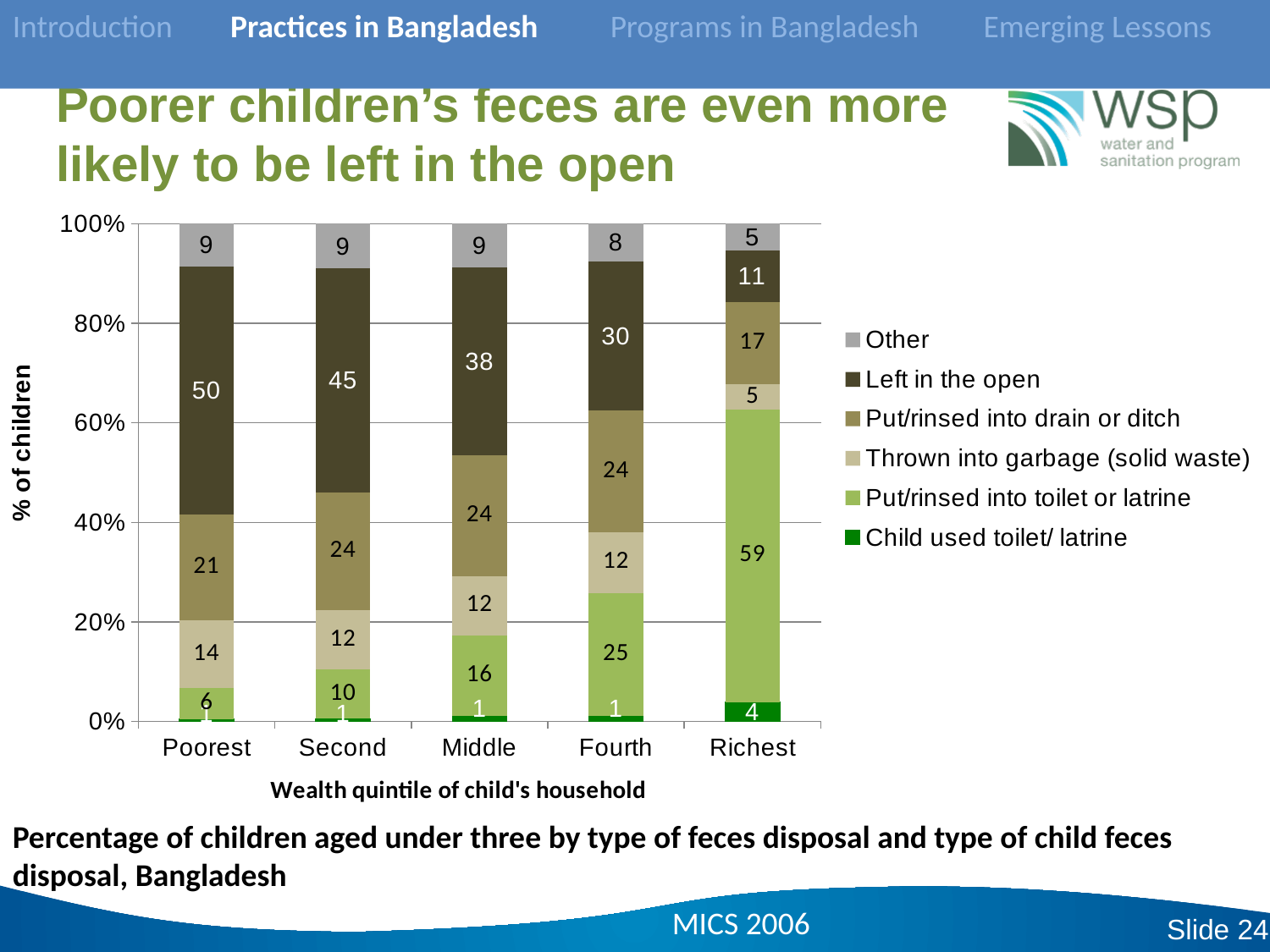
What is the value for "Left in the open" for the Poorest quintile? 50 How many series does the legend list? 6 Which wealth quintile has the lowest value for "Left in the open"? Richest Do the "Left in the open" values rise or fall from the Poorest to the Richest quintile? Fall Which has a larger value for "Put/rinsed into toilet or latrine": the Fourth quintile or the Middle quintile? Fourth What kind of chart is shown on the slide? Stacked bar chart What is the value for "Thrown into garbage (solid waste)" for the Middle quintile? 12 What is the difference between the "Left in the open" values for the Poorest and Richest quintiles? 39 What is the label of the x axis of the chart? Wealth quintile of child's household How many wealth quintile categories are shown on the x axis? 5 Which wealth quintile has the highest value for "Left in the open"? Poorest What is the value for "Put/rinsed into toilet or latrine" for the Richest quintile? 59